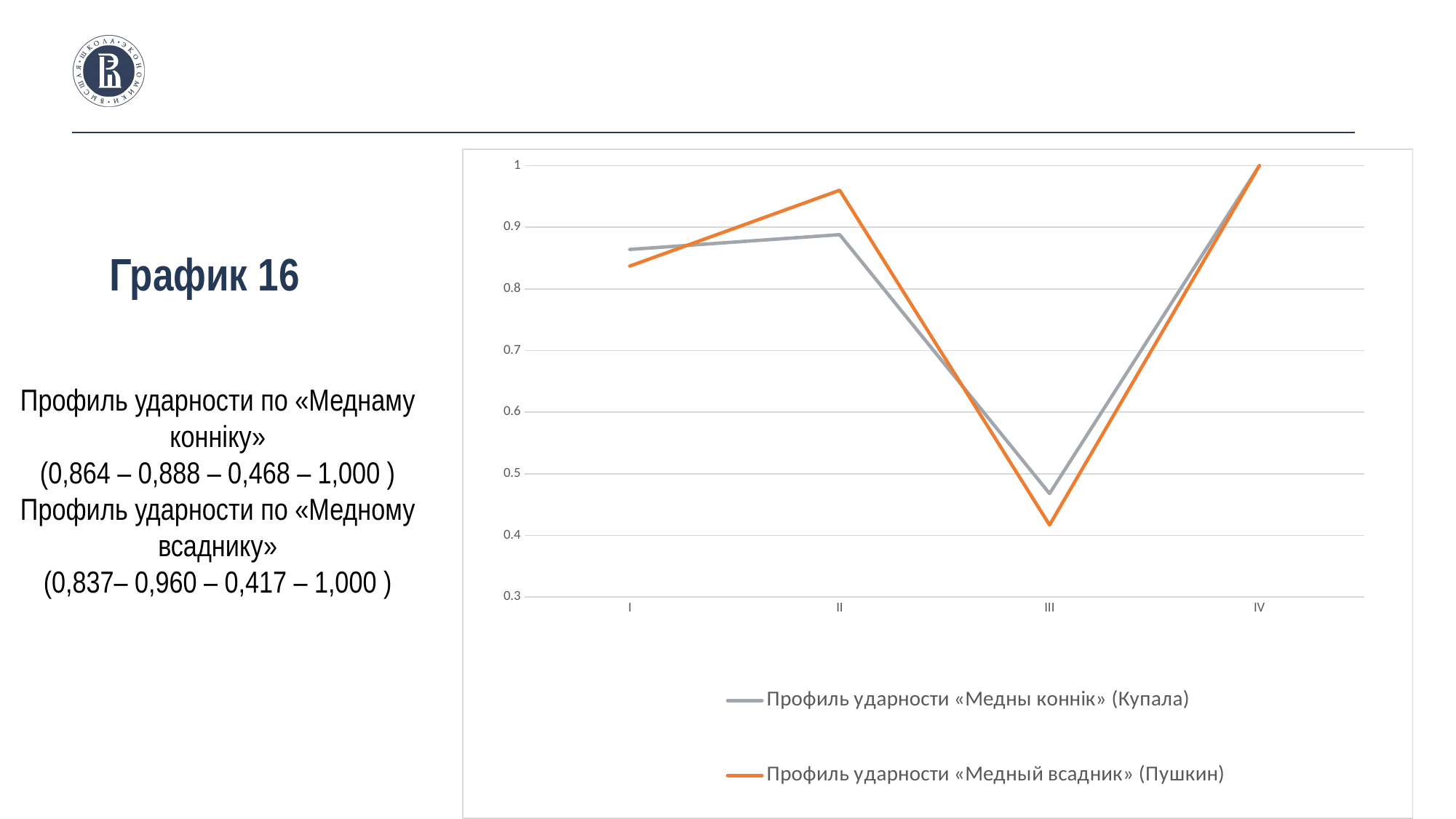
What is the value of the Pushkin series («Медный всадник») at point I? 0,837 At which x-axis point is the Kupala series («Медны коннік») lowest? III What is the value of the Pushkin series («Медный всадник») at point II? 0,960 Is the value of the Pushkin series («Медный всадник») at point III greater or less than 0.5? less What colour is the line for the Pushkin series («Медный всадник»)? orange What kind of chart is shown on the slide? line chart At which x-axis point is the Pushkin series («Медный всадник») highest? IV How many series does the legend list? 2 How many points are plotted along the x axis for each series? 4 Which series has the larger value at point II, Kupala or Pushkin? Pushkin Do the values of both series rise or fall from point II to point III? fall What is the value of the Kupala series («Медны коннік») at point III? 0,468